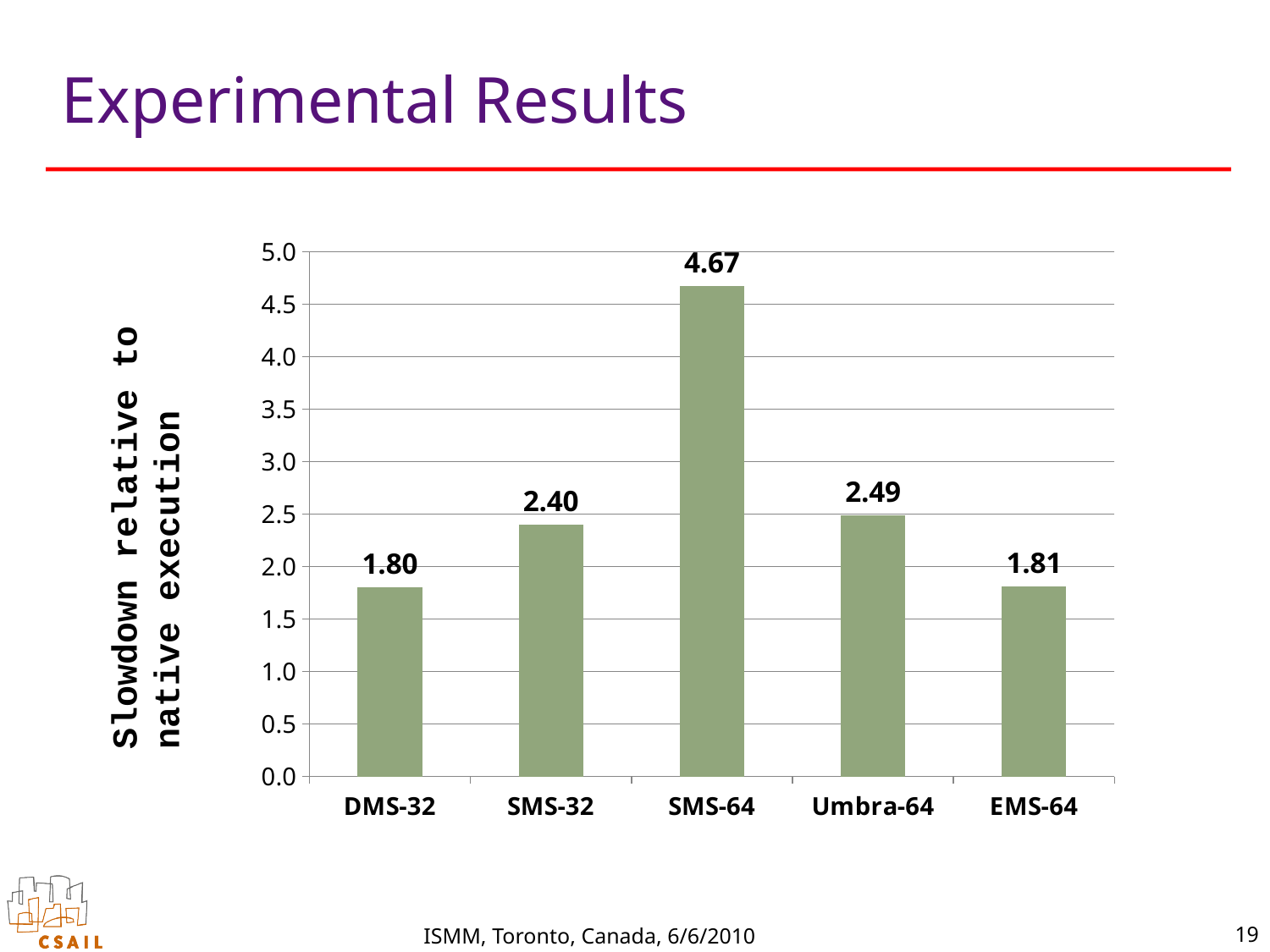
Which category has the highest slowdown? SMS-64 Which category has the lowest slowdown? DMS-32 What is the difference between the values for SMS-64 and SMS-32? 2.27 What kind of chart is shown on the slide? bar chart What is the slowdown relative to native execution for DMS-32? 1.80 Is the value for SMS-64 greater or less than 4.5? greater What is the label of the y axis? Slowdown relative to native execution Which has a larger slowdown, SMS-32 or Umbra-64? Umbra-64 What is the difference between the values for Umbra-64 and EMS-64? 0.68 What is the slowdown relative to native execution for SMS-64? 4.67 How many categories are shown on the x axis? 5 What is the value shown for Umbra-64? 2.49